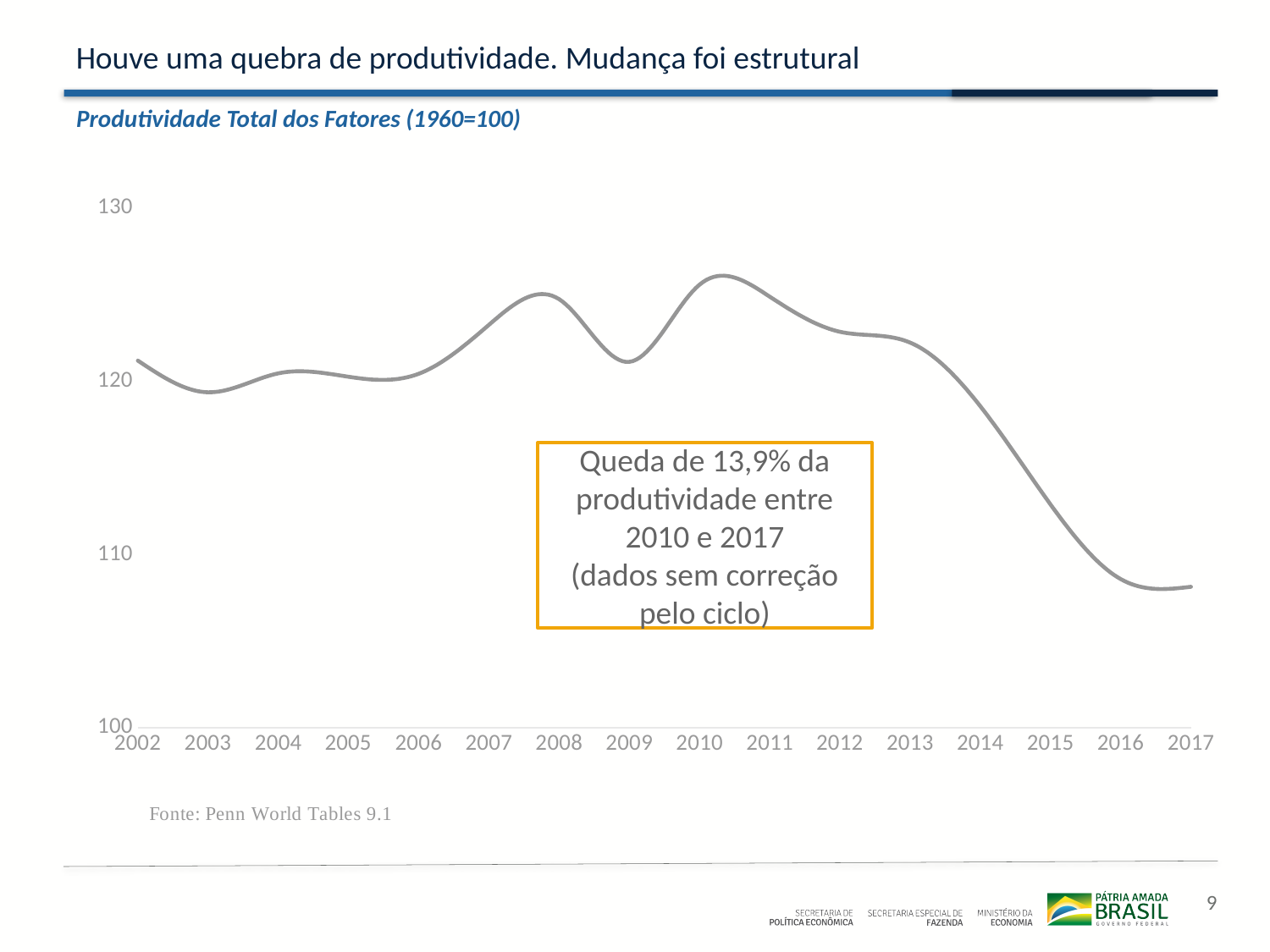
According to the annotation box on the chart, by what percentage did productivity fall between 2010 and 2017? 13,9% How many years are plotted along the x axis of the chart? 16 In which year does the productivity line reach its highest point? 2010 Is the value for 2017 greater or less than 110? less Does the productivity line rise or fall between 2013 and 2016? fall Is the value for 2015 greater or less than 110? greater What is the title of the chart? Produtividade Total dos Fatores (1960=100) Is the value for 2010 greater or less than 120? greater Which year has the higher productivity value, 2008 or 2009? 2008 Which year has the higher productivity value, 2010 or 2017? 2010 What kind of chart is shown on the slide? line chart